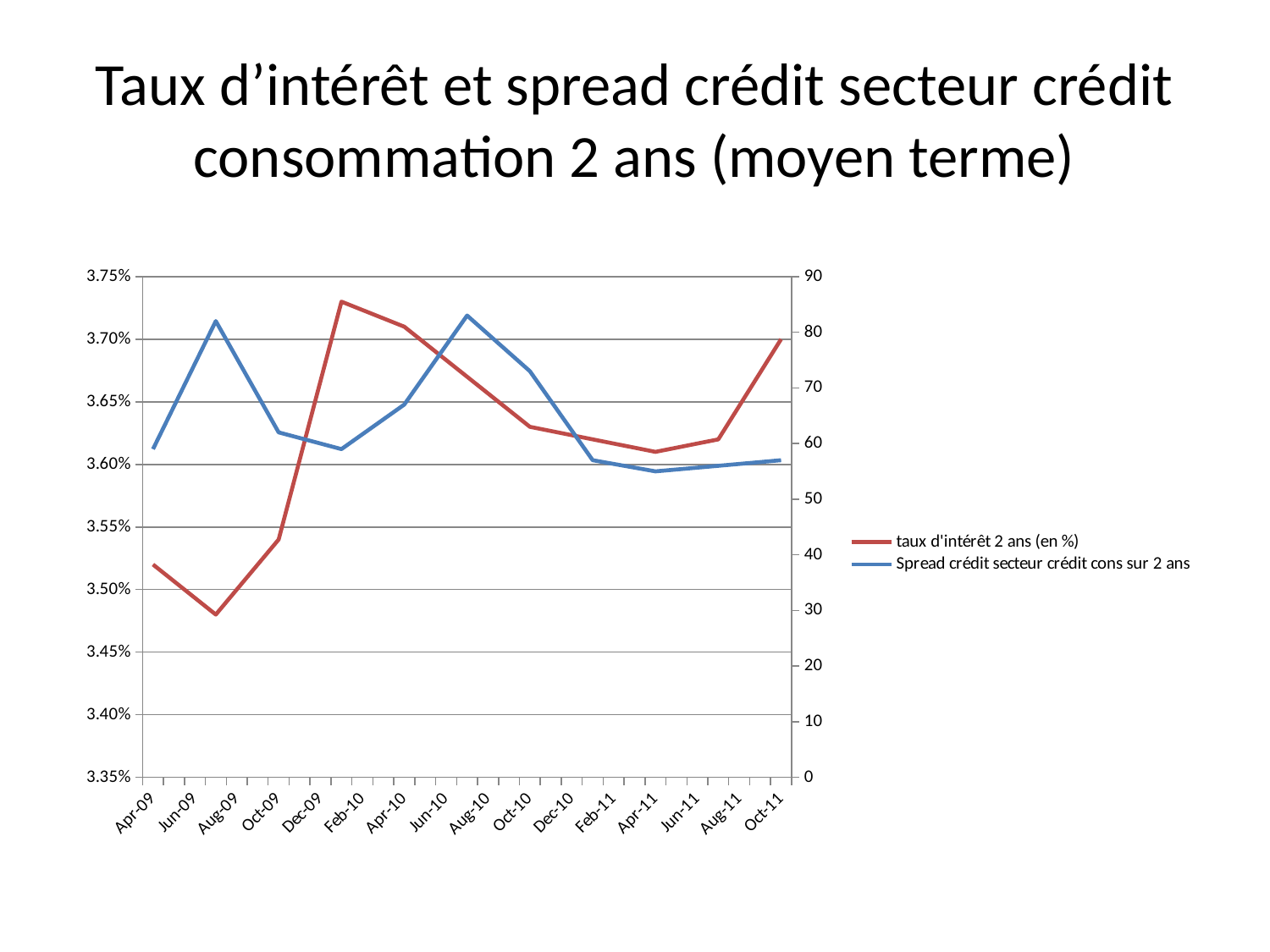
What is the title of the chart? Taux d’intérêt et spread crédit secteur crédit consommation 2 ans (moyen terme) Is the value of 'Spread crédit secteur crédit cons sur 2 ans' at Apr-11 greater or less than 60? less Is the value of 'Spread crédit secteur crédit cons sur 2 ans' at Aug-09 greater or less than 70? greater What kind of chart is shown on the slide? line chart Does the 'Spread crédit secteur crédit cons sur 2 ans' series rise or fall between Aug-10 and Apr-11? fall Which colour is used for the series 'Spread crédit secteur crédit cons sur 2 ans'? blue Does the 'taux d'intérêt 2 ans (en %)' series rise or fall between Jun-09 and Feb-10? rise How many series does the legend list? 2 Is the value of 'taux d'intérêt 2 ans (en %)' at Feb-10 greater or less than 3.70%? greater